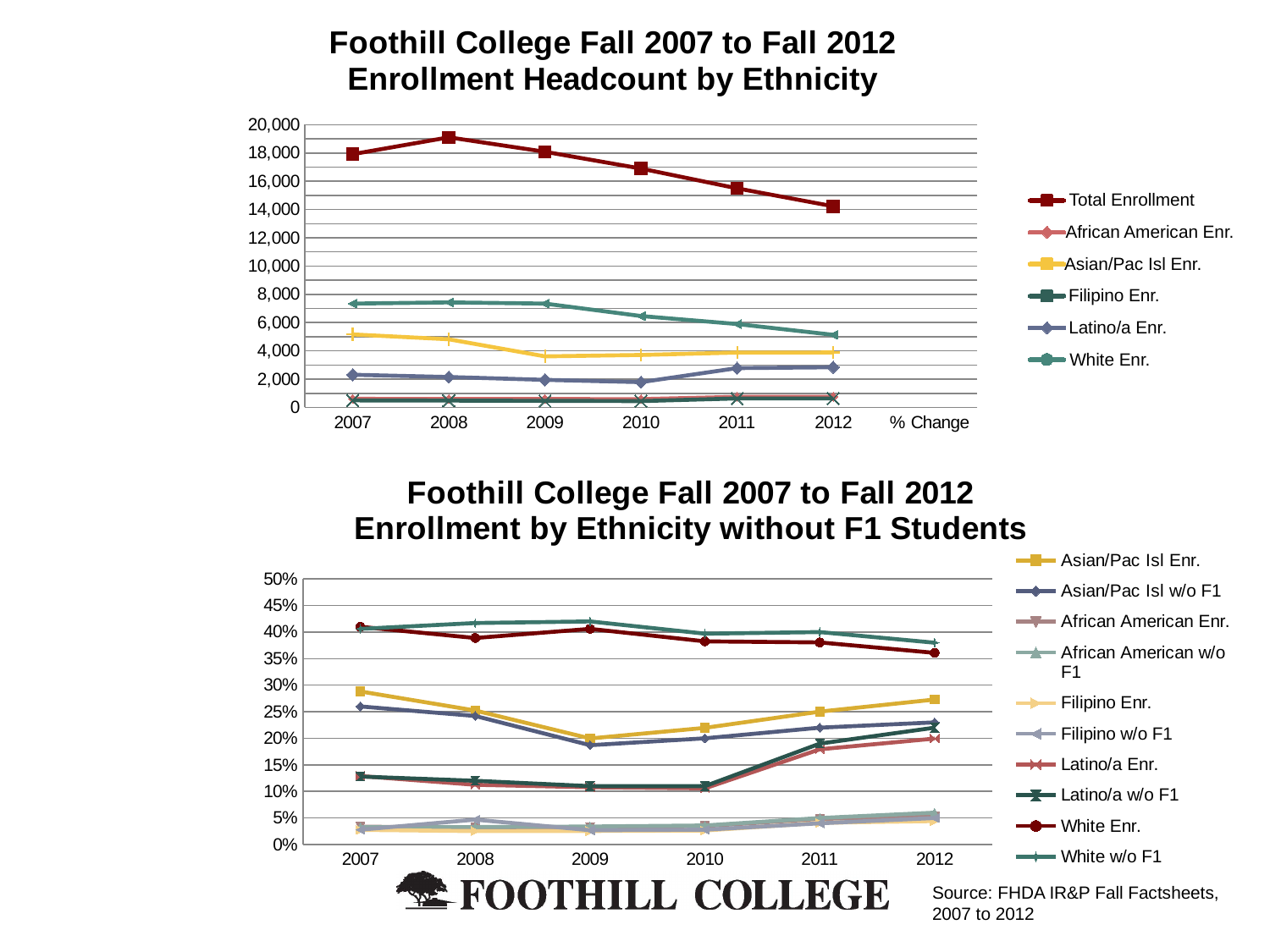
In the top chart, 'Enrollment Headcount by Ethnicity', does Total Enrollment rise or fall from 2008 to 2012? Fall In the bottom chart, 'Enrollment by Ethnicity without F1 Students', how many series does the legend list? 10 In the bottom chart, 'Enrollment by Ethnicity without F1 Students', is the White Enr. value for 2012 greater or less than 40%? less What type of chart is the top chart, 'Enrollment Headcount by Ethnicity'? Line chart In the top chart, 'Enrollment Headcount by Ethnicity', how many years are plotted for each series? 6 In the top chart, 'Enrollment Headcount by Ethnicity', how many series does the legend list? 6 In the top chart, 'Enrollment Headcount by Ethnicity', in which year is Total Enrollment lowest? 2012 In the top chart, 'Enrollment Headcount by Ethnicity', is the Total Enrollment value for 2012 greater or less than 16,000? less In the top chart, 'Enrollment Headcount by Ethnicity', in which year is Total Enrollment highest? 2008 In the bottom chart, 'Enrollment by Ethnicity without F1 Students', in which year is Asian/Pac Isl Enr. lowest? 2009 In the top chart, 'Enrollment Headcount by Ethnicity', is the White Enr. value for 2007 greater or less than 6,000? greater In the top chart, 'Enrollment Headcount by Ethnicity', which is larger in 2007: Asian/Pac Isl Enr. or Latino/a Enr.? Asian/Pac Isl Enr.